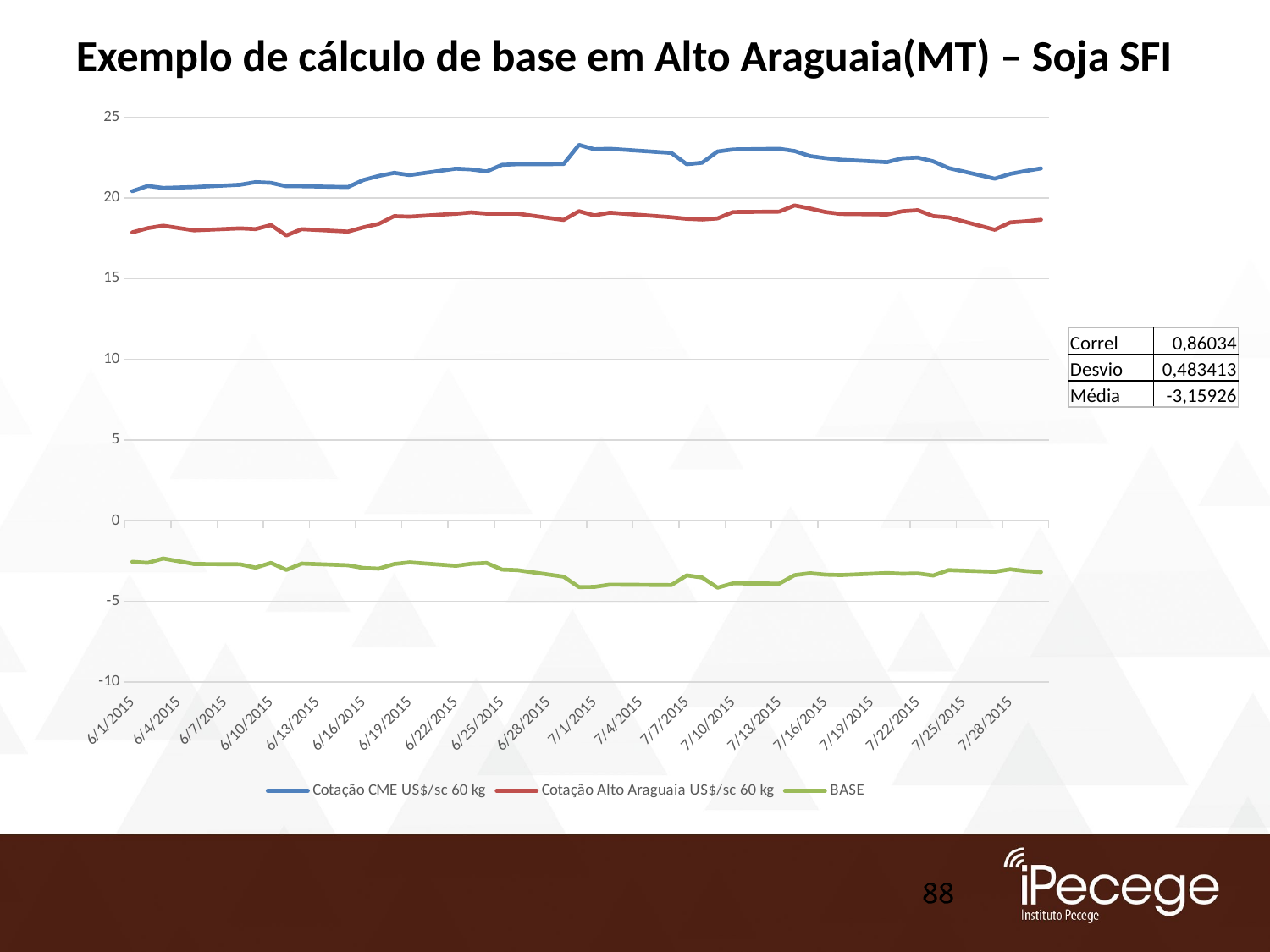
Is the value of Cotação Alto Araguaia US$/sc 60 kg on 6/1/2015 greater or less than 20? less Which series has the lowest values across the whole period? BASE Does the Cotação CME US$/sc 60 kg series rise or fall from 6/1/2015 to 7/1/2015? rise What kind of chart is shown on the slide? line chart How many series does the legend list? 3 On 6/1/2015, which is larger: Cotação CME US$/sc 60 kg or Cotação Alto Araguaia US$/sc 60 kg? Cotação CME US$/sc 60 kg What is the title of the slide containing the chart? Exemplo de cálculo de base em Alto Araguaia(MT) – Soja SFI Is the value of BASE on 6/1/2015 greater or less than -5? greater Is the value of BASE on 7/1/2015 greater or less than 0? less Which series reaches the highest values on the chart? Cotação CME US$/sc 60 kg What colour is the BASE series line? green